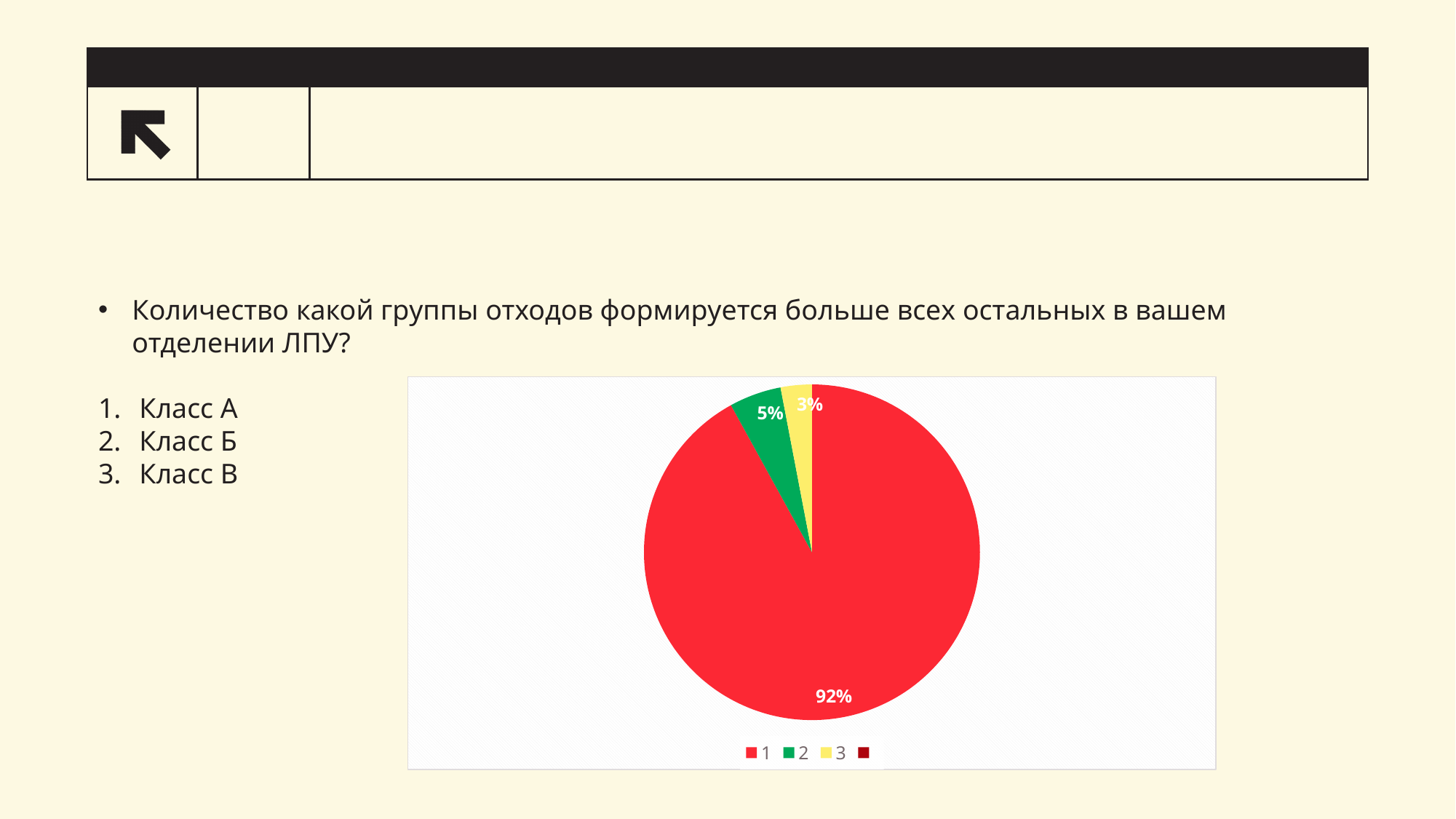
What share of the pie does slice 2 take? 5% What colour is slice 3 in the pie chart? yellow What is the difference in percentage points between slice 2 and slice 3? 2 What share of the pie does slice 1 take? 92% Which slice of the pie is the largest? 1 What is the difference in percentage points between slice 1 and slice 2? 87 What share of the pie does slice 3 take? 3% What colour is slice 1 in the pie chart? red Which labelled slice of the pie is the smallest? 3 Which is larger, slice 2 or slice 3? 2 How many slices of the pie have a percentage label? 3 What kind of chart is shown on the slide? pie chart